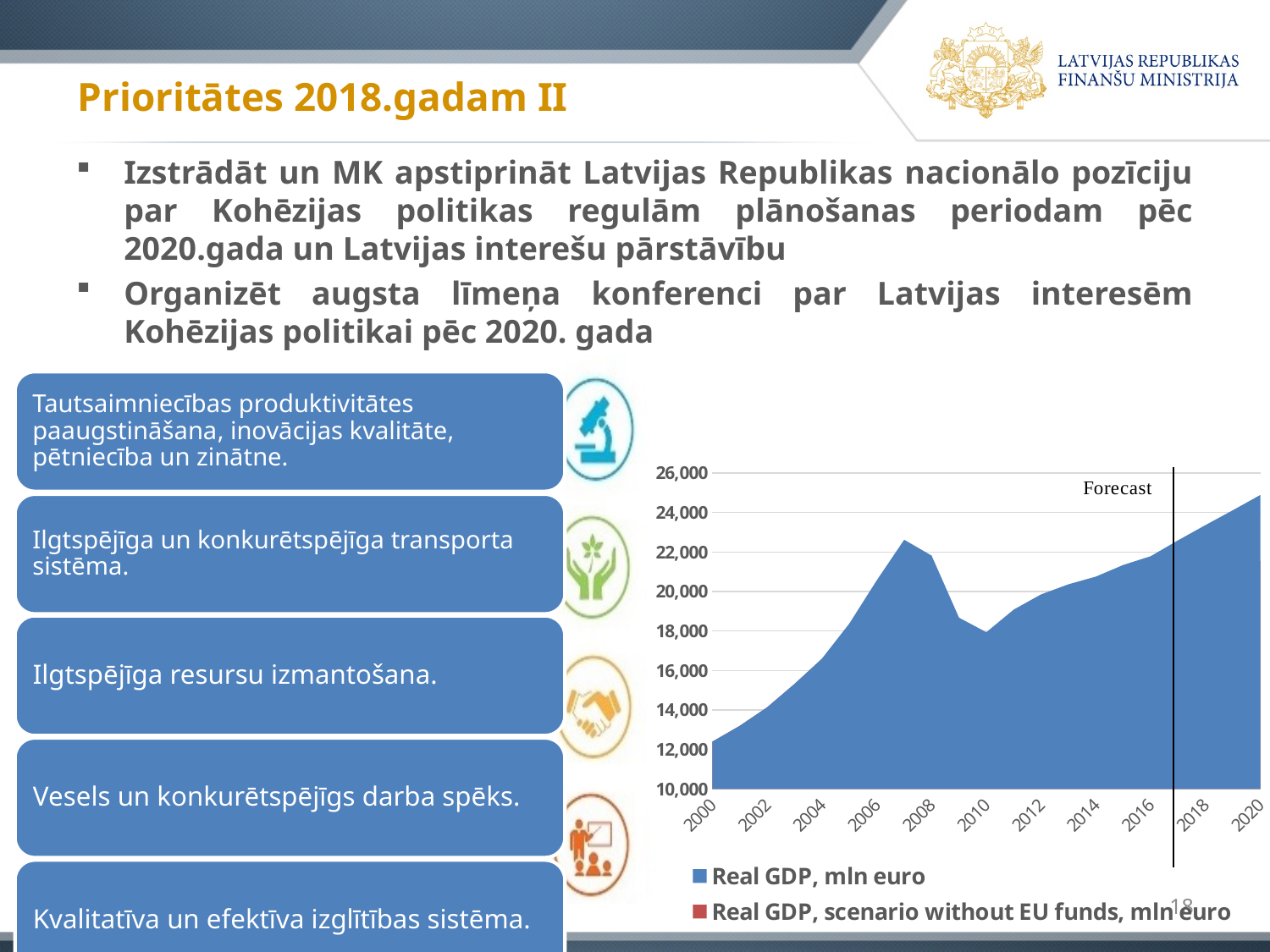
Which year has the larger Real GDP, mln euro: 2007 or 2010? 2007 How many series does the chart legend list? 2 Does Real GDP, mln euro rise or fall between 2008 and 2010? fall How many year labels are shown on the x axis of the chart? 11 What label appears near the vertical line on the right side of the chart? Forecast In which year is Real GDP, mln euro at its lowest on the chart? 2000 Is the value of Real GDP, mln euro in 2020 greater or less than 24,000? greater What kind of chart is shown on the slide? area chart Is the value of Real GDP, mln euro in 2016 greater or less than 20,000? greater In which year is Real GDP, mln euro at its highest on the chart? 2020 What is the first series named in the chart legend? Real GDP, mln euro Is the value of Real GDP, mln euro in 2000 greater or less than 14,000? less